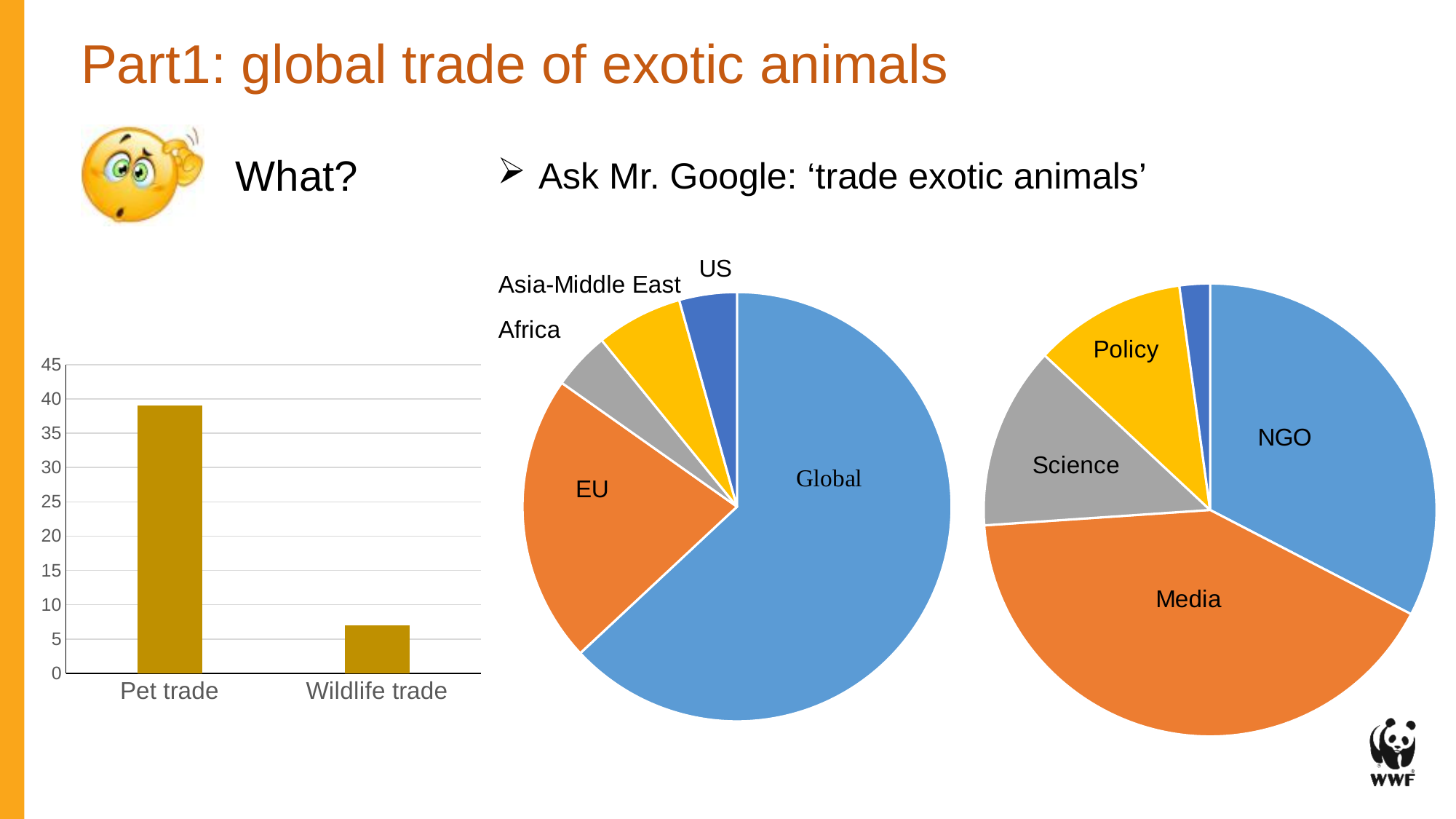
In the middle pie chart, which slice is the largest? Global In the middle pie chart, which is larger, the EU slice or the Asia-Middle East slice? EU In the bar chart on the left, which category has the highest value? Pet trade In the pie chart on the right, which is larger, the NGO slice or the Science slice? NGO What kind of chart is the chart on the left of the slide? bar chart In the pie chart on the right, which slice is the largest? Media How many slices are in the middle pie chart? 5 In the bar chart on the left, is the value for Pet trade greater or less than 35? greater In the bar chart on the left, which category has the lowest value? Wildlife trade In the bar chart on the left, is the value for Wildlife trade greater or less than 10? less How many categories are shown in the bar chart on the left? 2 What kind of chart is the middle chart on the slide? pie chart